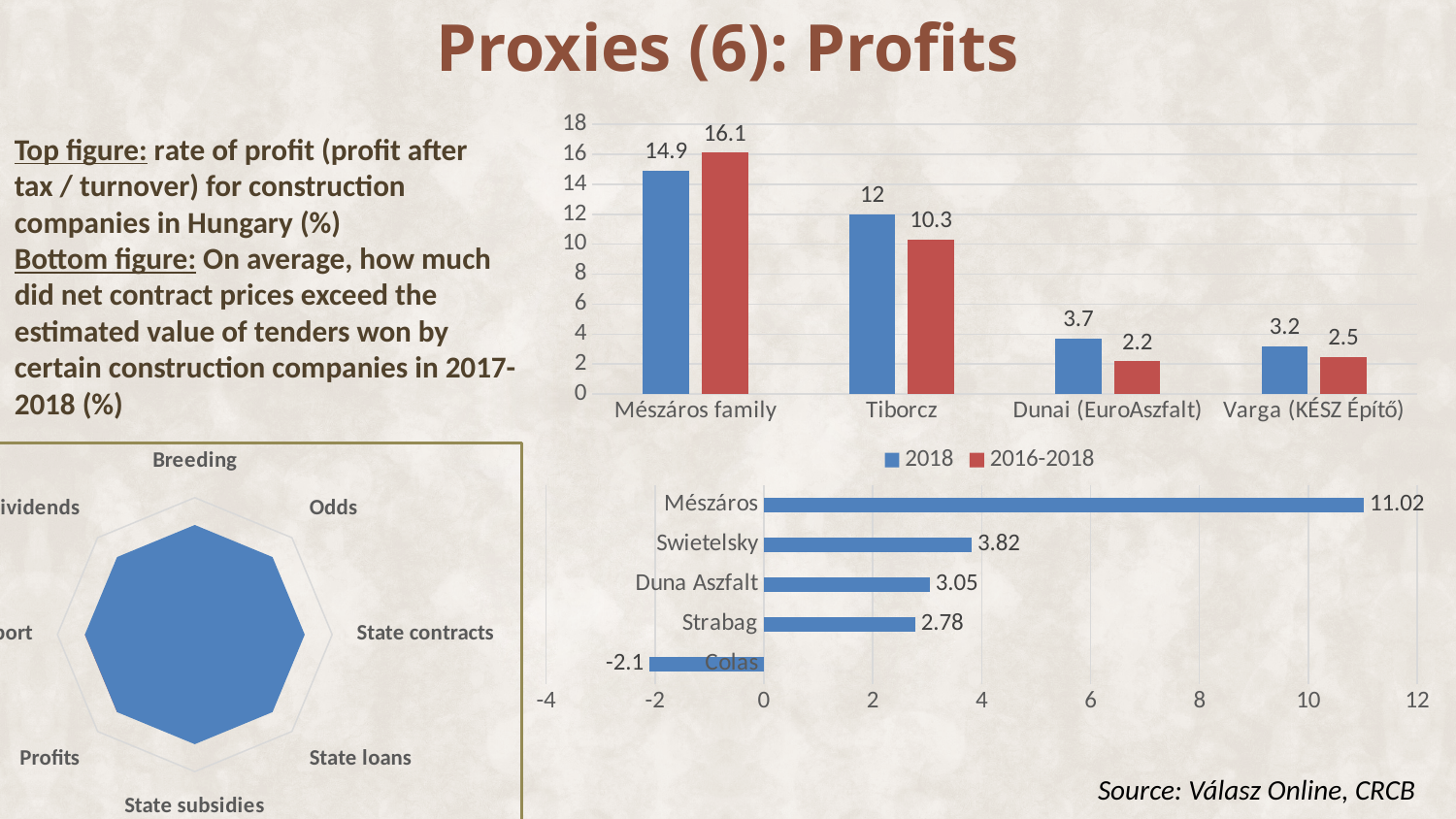
In the bottom chart, which company has the lowest value? Colas In the top chart, what is the 2018 value for Mészáros family? 14.9 What kind of chart is the bottom chart? Bar chart In the top chart, which category has the highest 2018 value? Mészáros family In the top chart, what is the difference between the 2018 and 2016-2018 values for Tiborcz? 1.7 In the bottom chart, which is larger, the value for Duna Aszfalt or the value for Strabag? Duna Aszfalt In the bottom chart, what is the value for Swietelsky? 3.82 In the bottom chart, what is the difference between the values for Mészáros and Swietelsky? 7.20 In the top chart, which category has the lowest 2016-2018 value? Dunai (EuroAszfalt) In the top chart, how many series does the legend list? 2 In the top chart, how many categories are shown on the x axis? 4 In the top chart, what is the 2016-2018 value for Tiborcz? 10.3